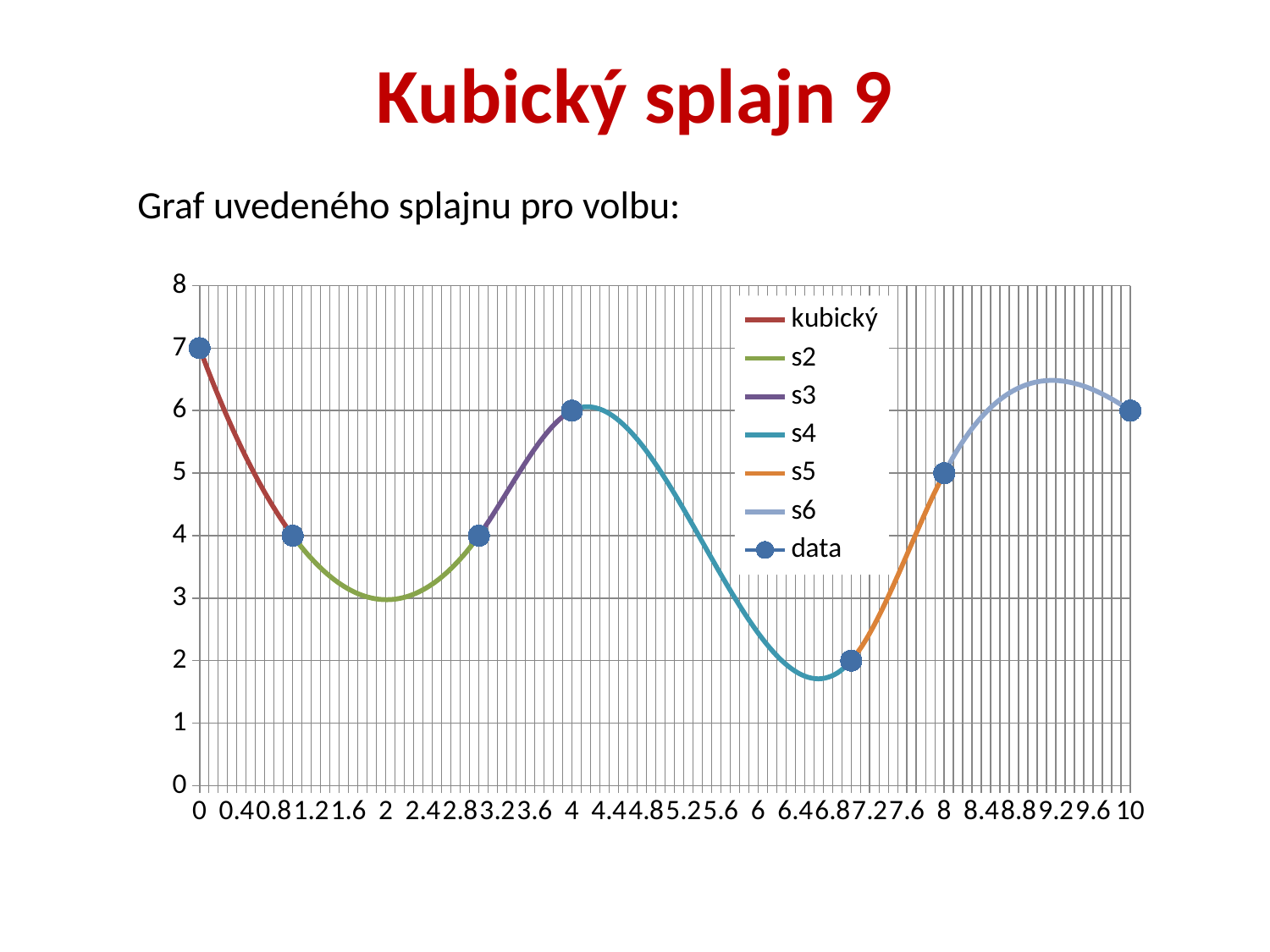
What is the highest value among the plotted data points? 7 What is the title of the slide containing the chart? Kubický splajn 9 How many data points are plotted in the 'data' series? 7 What is the value of the 'data' series at x = 4? 6 How many series does the legend list? 7 What is the lowest value among the plotted data points? 2 What type of chart is shown on the slide? line chart What is the difference between the data value at x = 0 and the data value at x = 10? 1 What is the value of the 'data' series at x = 8? 5 What is the value of the 'data' series at x = 10? 6 Is the minimum of the s4 segment greater or less than 2? less What is the value of the 'data' series at x = 0? 7